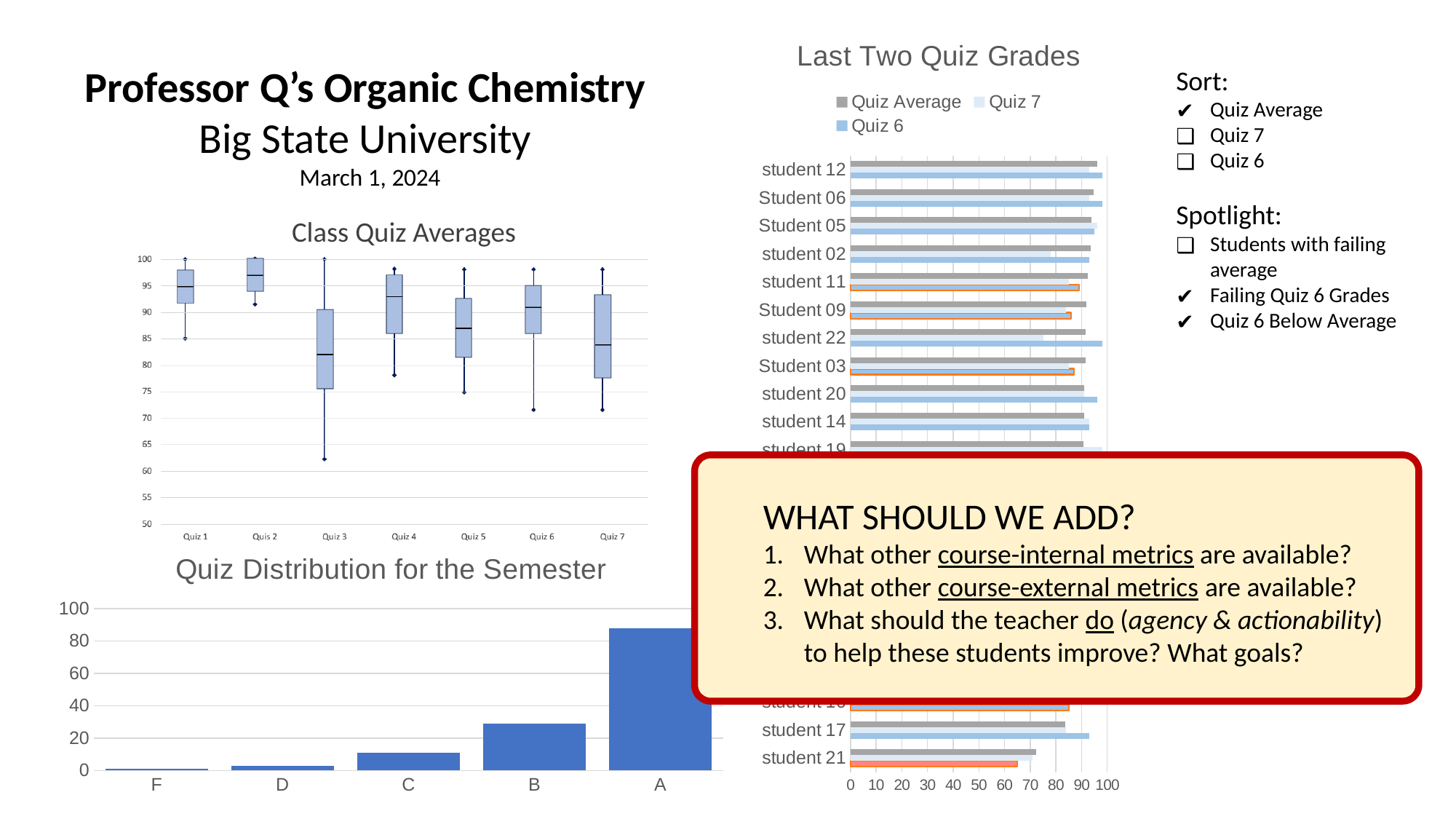
What kind of chart is the "Quiz Distribution for the Semester" chart? bar chart In the "Quiz Distribution for the Semester" chart, do the values rise or fall going from F to A along the x axis? rise In the "Quiz Distribution for the Semester" chart, is the value for A greater or less than 80? greater How many grade categories does the "Quiz Distribution for the Semester" chart show? 5 In the "Class Quiz Averages" chart, which quiz has the lowest median? Quiz 3 How many series does the legend of the "Last Two Quiz Grades" chart list? 3 In the "Class Quiz Averages" chart, is the lowest whisker value for Quiz 3 greater or less than 65? less In the "Quiz Distribution for the Semester" chart, which grade category has the highest value? A How many quizzes are shown on the x axis of the "Class Quiz Averages" chart? 7 In the "Last Two Quiz Grades" chart, is the Quiz 6 value for student 21 greater or less than 70? less In the "Quiz Distribution for the Semester" chart, which grade category has the lowest value? F